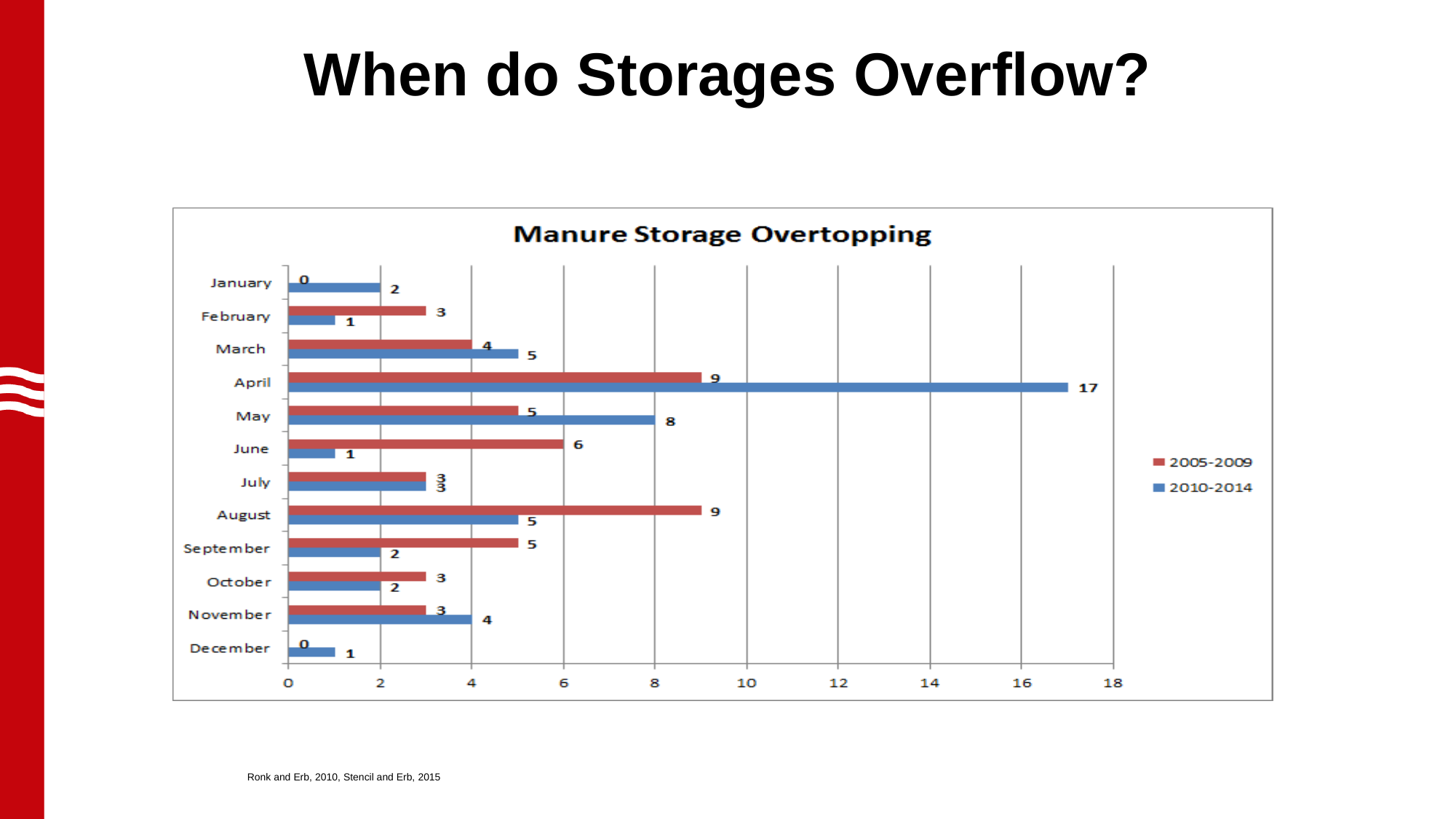
What is the difference between the 2010-2014 and 2005-2009 values for April? 8 What is the value for April in the 2010-2014 series? 17 Which month has the lowest value in the 2010-2014 series? June, February and December (all 1) Which colour represents the 2010-2014 series? Blue What is the value for June in the 2010-2014 series? 1 How many series does the legend list? 2 Which is larger for September: the 2005-2009 value or the 2010-2014 value? 2005-2009 Which month has the highest value in the 2010-2014 series? April What is the title of the chart? Manure Storage Overtopping What is the value for August in the 2005-2009 series? 9 What kind of chart is shown? Bar chart How many months are shown on the chart? 12